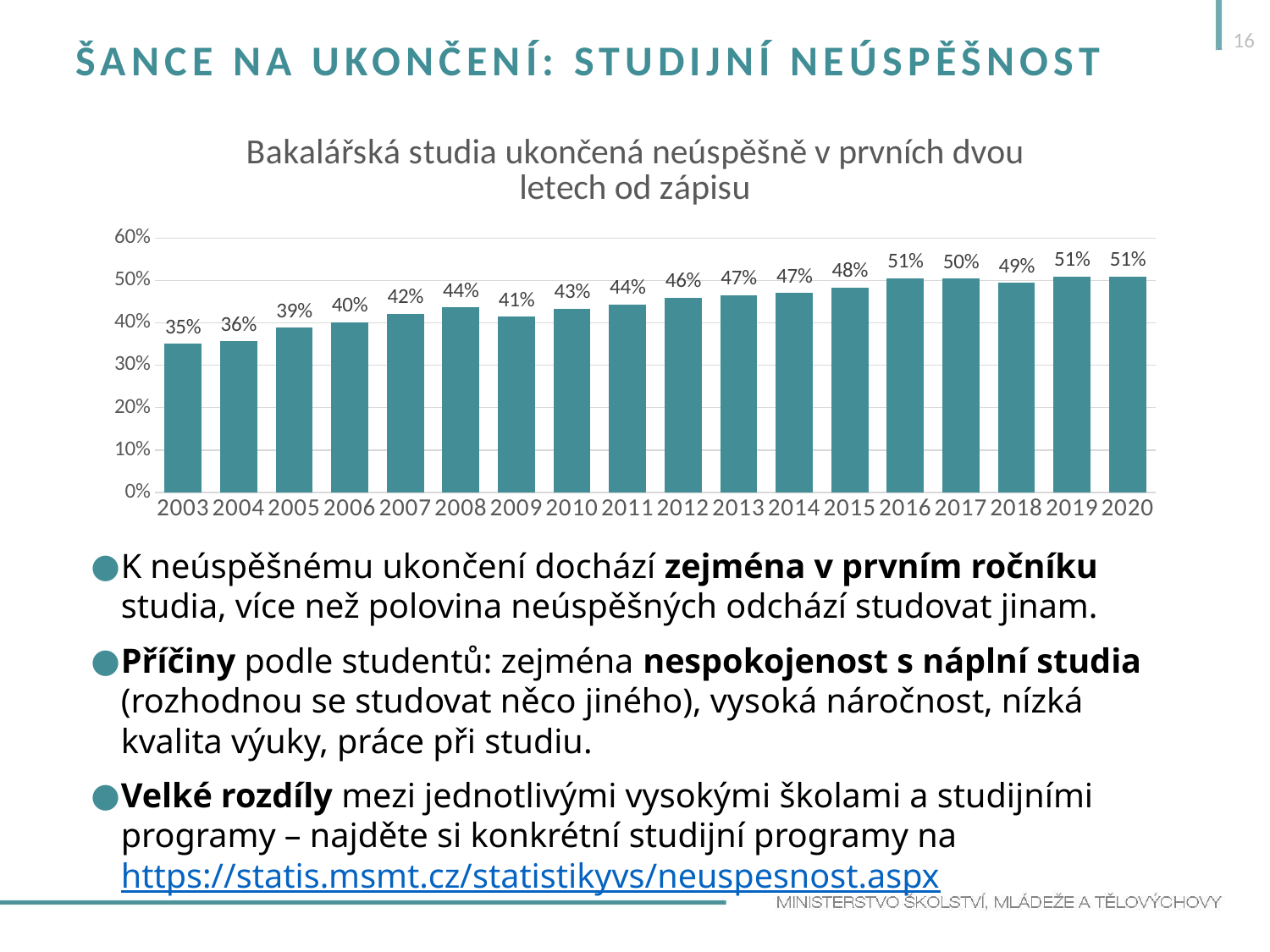
What is the value for 2012? 46% Is the value for 2005 greater or less than 40%? less What is the difference between the values for 2020 and 2003? 16% What is the value for 2020? 51% What is the difference between the values for 2008 and 2009? 3% Which is larger, the value for 2017 or the value for 2018? 2017 What is the value for 2009? 41% What kind of chart is shown on the slide? bar chart How many years are shown on the x axis? 18 Do the values generally rise or fall from 2003 to 2020? rise Which year has the lowest value? 2003 What is the value for 2003? 35%